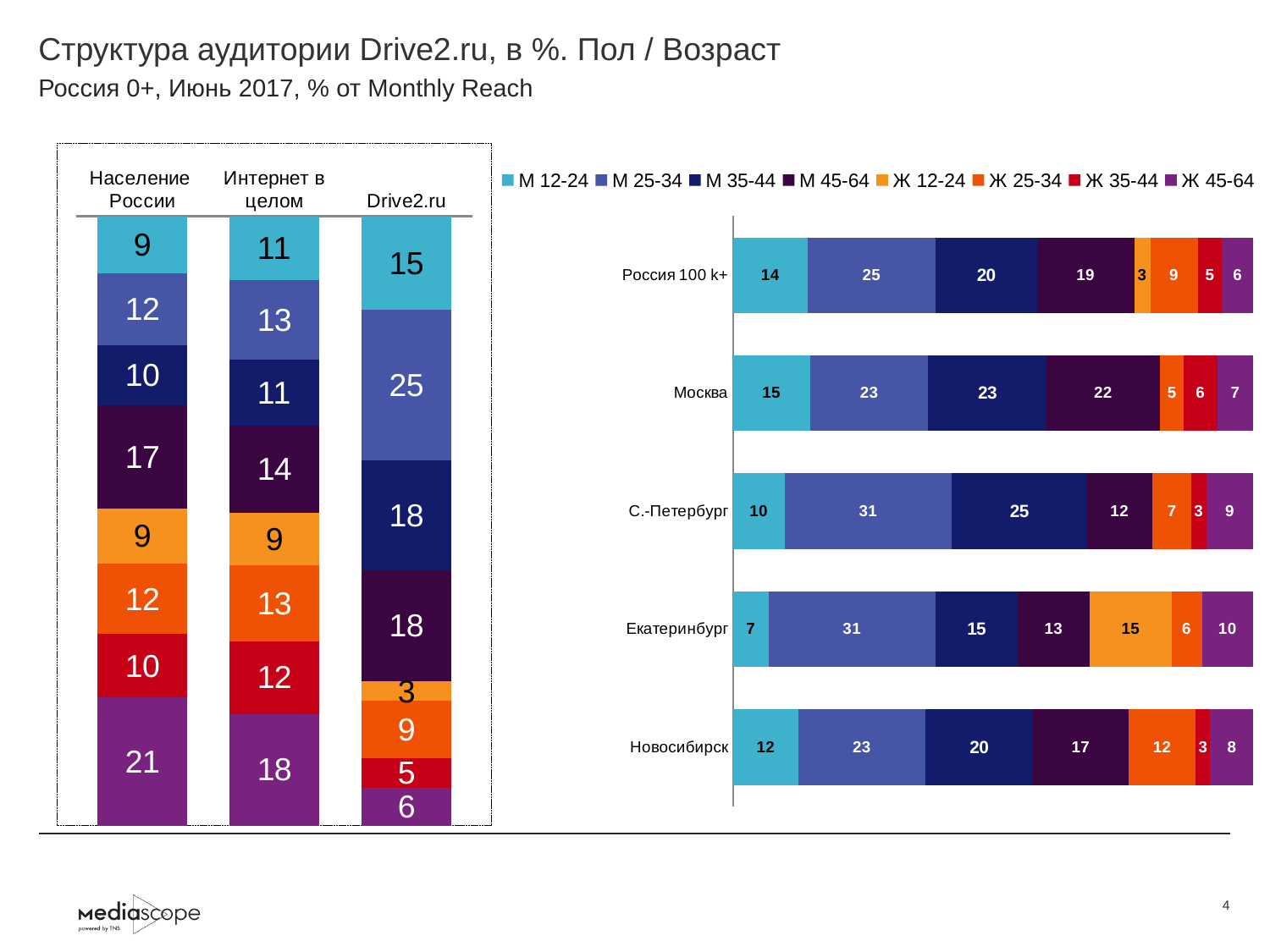
In the left chart, what is the value for Ж 45-64 in the Население России bar? 21 In the right chart, what is the total of the Россия 100 k+ bar? 101 In the right chart, what is the value for Ж 12-24 for Екатеринбург? 15 In the right chart, which city has the larger М 35-44 value, Москва or Новосибирск? Москва What kind of chart is the right chart? Stacked bar chart In the left chart, what is the value for М 25-34 in the Drive2.ru bar? 25 In the left chart, which segment is the smallest in the Drive2.ru bar? Ж 12-24 How many categories (rows) are shown in the right chart? 5 How many series does the legend on the right chart list? 8 In the left chart, which segment is the largest in the Интернет в целом bar? Ж 45-64 In the left chart, what is the difference between the М 25-34 values for Drive2.ru and Население России? 13 In the right chart, what is the value for М 25-34 for С.-Петербург? 31